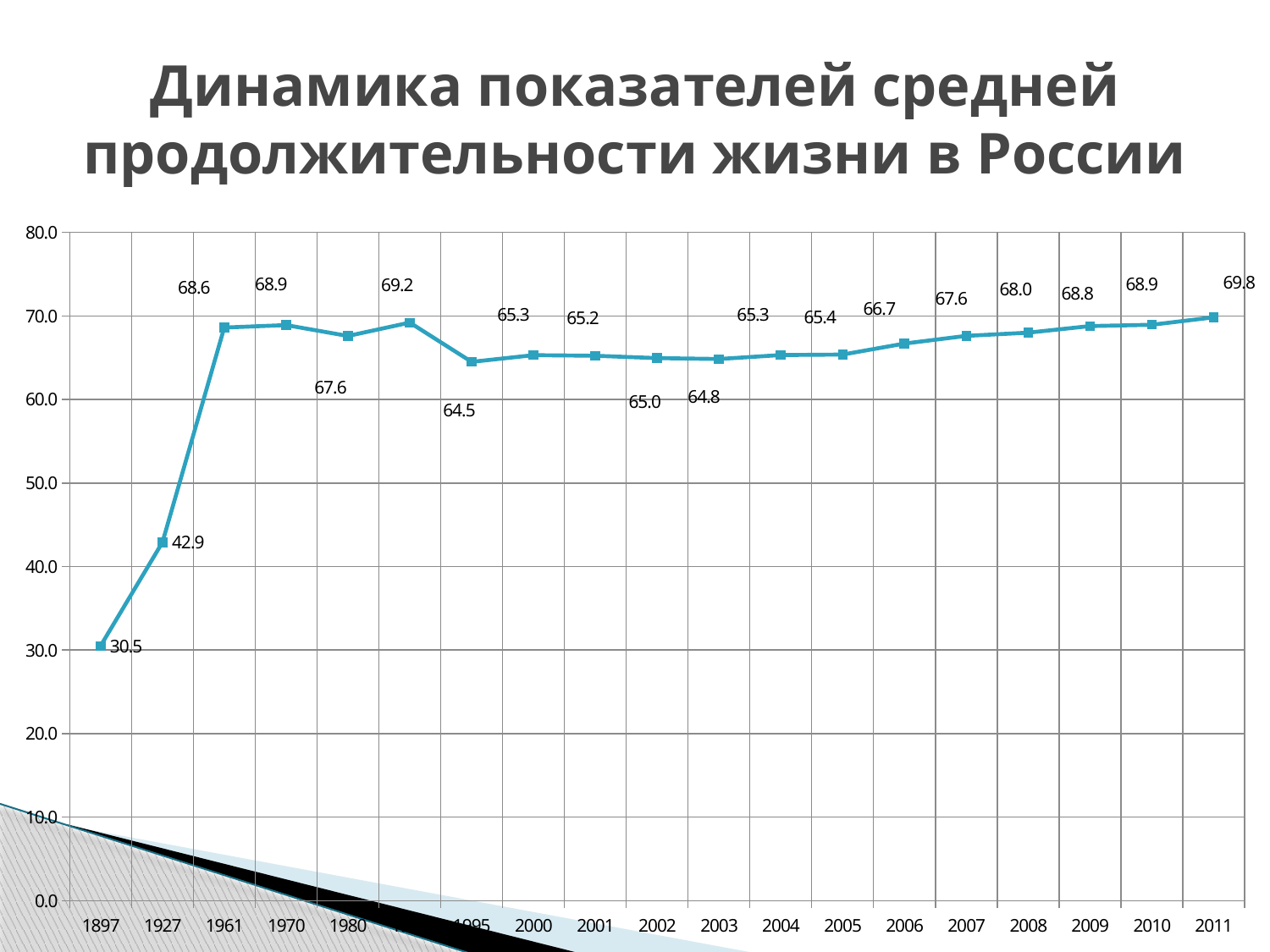
What is the average life expectancy value shown for 1897? 30.5 Is the value for 1927 greater or less than 50.0? less Which is larger, the value for 2000 or the value for 2003? 2000 What is the value shown for 1927? 42.9 What is the title of the chart on the slide? Динамика показателей средней продолжительности жизни в России What type of chart is shown on the slide? line chart Do the values rise or fall from 2003 to 2011? rise What is the difference between the values for 2011 and 1897? 39.3 What is the value shown for 2011? 69.8 Which year has the lowest value on the chart? 1897 What is the value shown for 1995? 64.5 Which year has the highest value on the chart? 2011